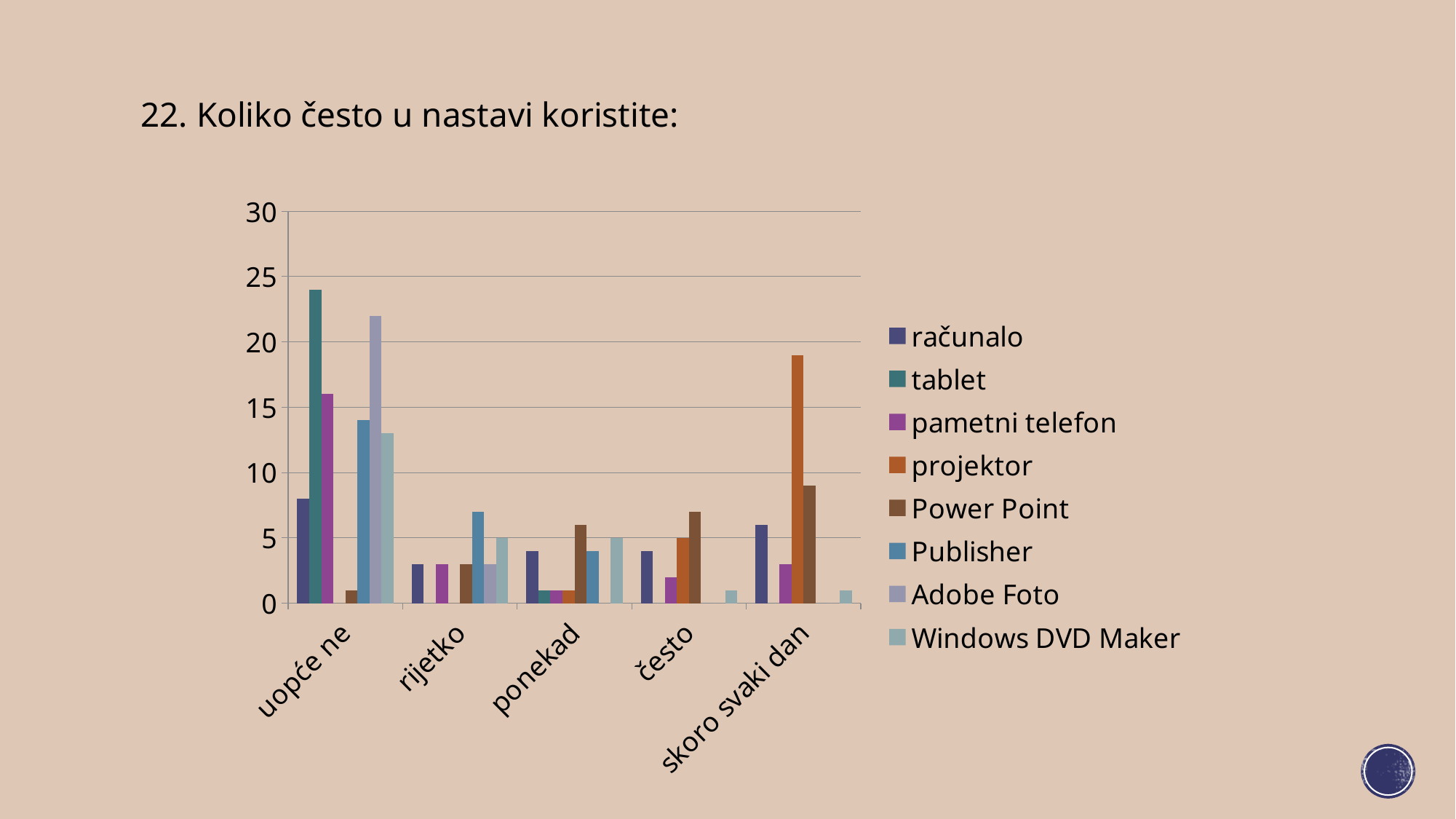
In the 'često' category, which is larger: Power Point or pametni telefon? Power Point Is the value for Adobe Foto in the 'uopće ne' category greater or less than 20? greater How many series does the legend list? 8 In which category does the projektor series reach its highest value? skoro svaki dan What kind of chart is shown on the slide? bar chart In the 'uopće ne' category, which is larger: tablet or Publisher? tablet What is the first entry listed in the chart legend? računalo Is the value for projektor in the 'skoro svaki dan' category greater or less than 15? greater Is the value for Publisher in the 'uopće ne' category greater or less than 10? greater How many categories are shown on the x axis of the chart? 5 Which series has the highest value in the 'skoro svaki dan' category? projektor